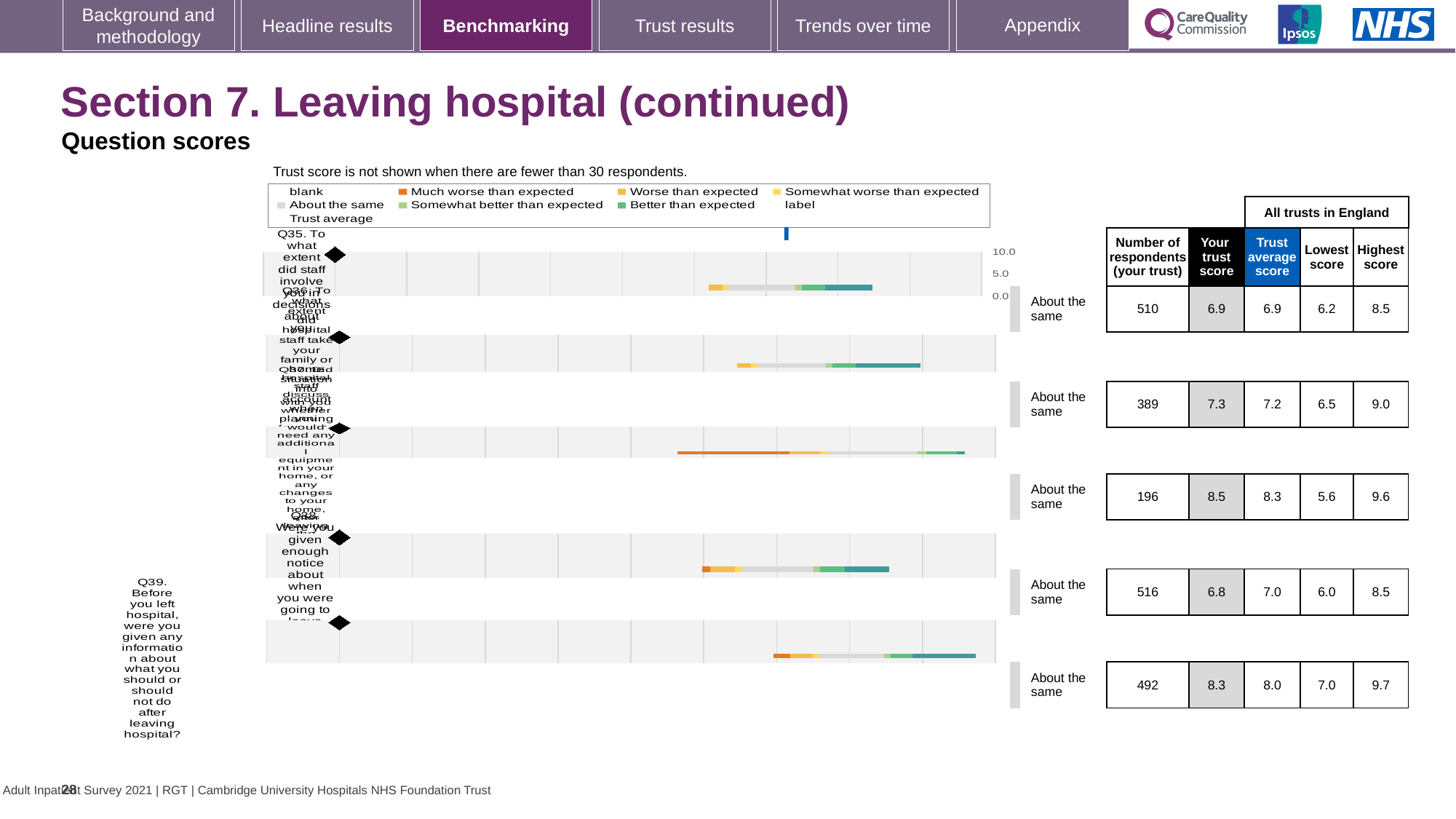
What kind of chart is used to show the question scores on this slide? bar chart What is the 'Your trust score' for Q39 (Before you left hospital, were you given any information about what you should or should not do after leaving hospital?)? 8.3 What is the highest score across all trusts in England for Q39? 9.7 What is the 'Trust average score' for Q39 in the table beside the chart? 8.0 What is the difference between the highest score (9.7) and the lowest score (7.0) for Q39? 2.7 What benchmark category is shown next to every question row in the chart? About the same How many respondents from your trust answered Q39? 492 Which row in the table has the highest 'Your trust score'? The third row (8.5) What is the 'Your trust score' for the first question row (Q35) in the table? 6.9 Which row in the table has the lowest number of respondents? The third row (196) For Q39, which is larger: your trust score or the trust average score? Your trust score How many question rows (diamond markers) are plotted in the chart? 5